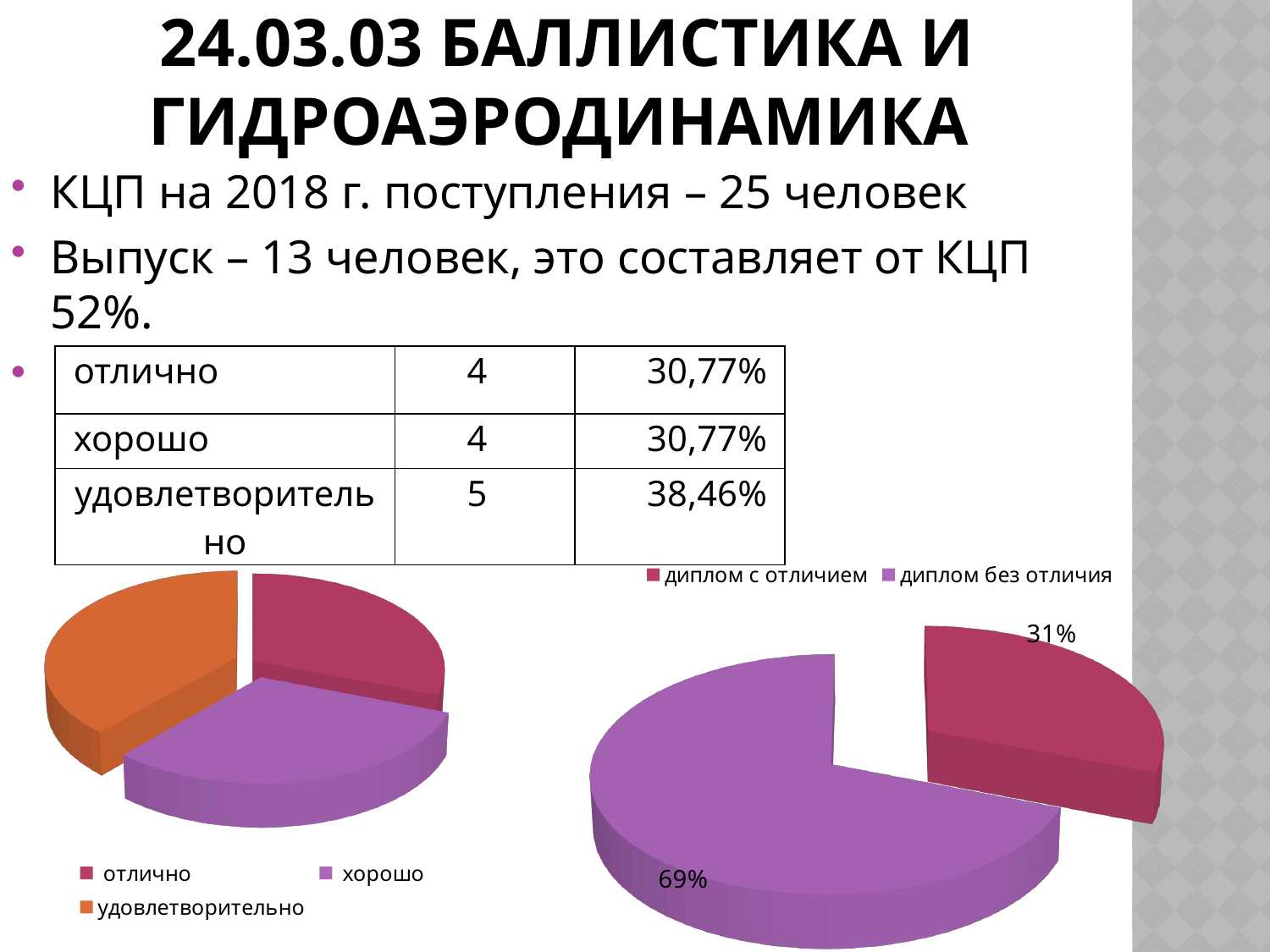
In the right pie chart, what share is labelled for 'диплом без отличия'? 69% In the right pie chart, what share is labelled for 'диплом с отличием'? 31% How many entries does the legend of the right pie chart list? 2 How many slices does the left pie chart have? 3 In the right pie chart, which slice is the smallest? диплом с отличием In the right pie chart, which is larger: 'диплом с отличием' or 'диплом без отличия'? диплом без отличия In the right pie chart, what is the difference in percentage points between 'диплом без отличия' and 'диплом с отличием'? 38 In the left pie chart, which colour is used for the 'удовлетворительно' slice? orange What kind of chart is the chart on the left of the slide (with legend 'отлично', 'хорошо', 'удовлетворительно')? pie chart In the left pie chart, which colour is used for the 'хорошо' slice? purple What kind of chart is the chart on the right of the slide (with legend 'диплом с отличием' and 'диплом без отличия')? pie chart In the right pie chart, which slice is the largest? диплом без отличия